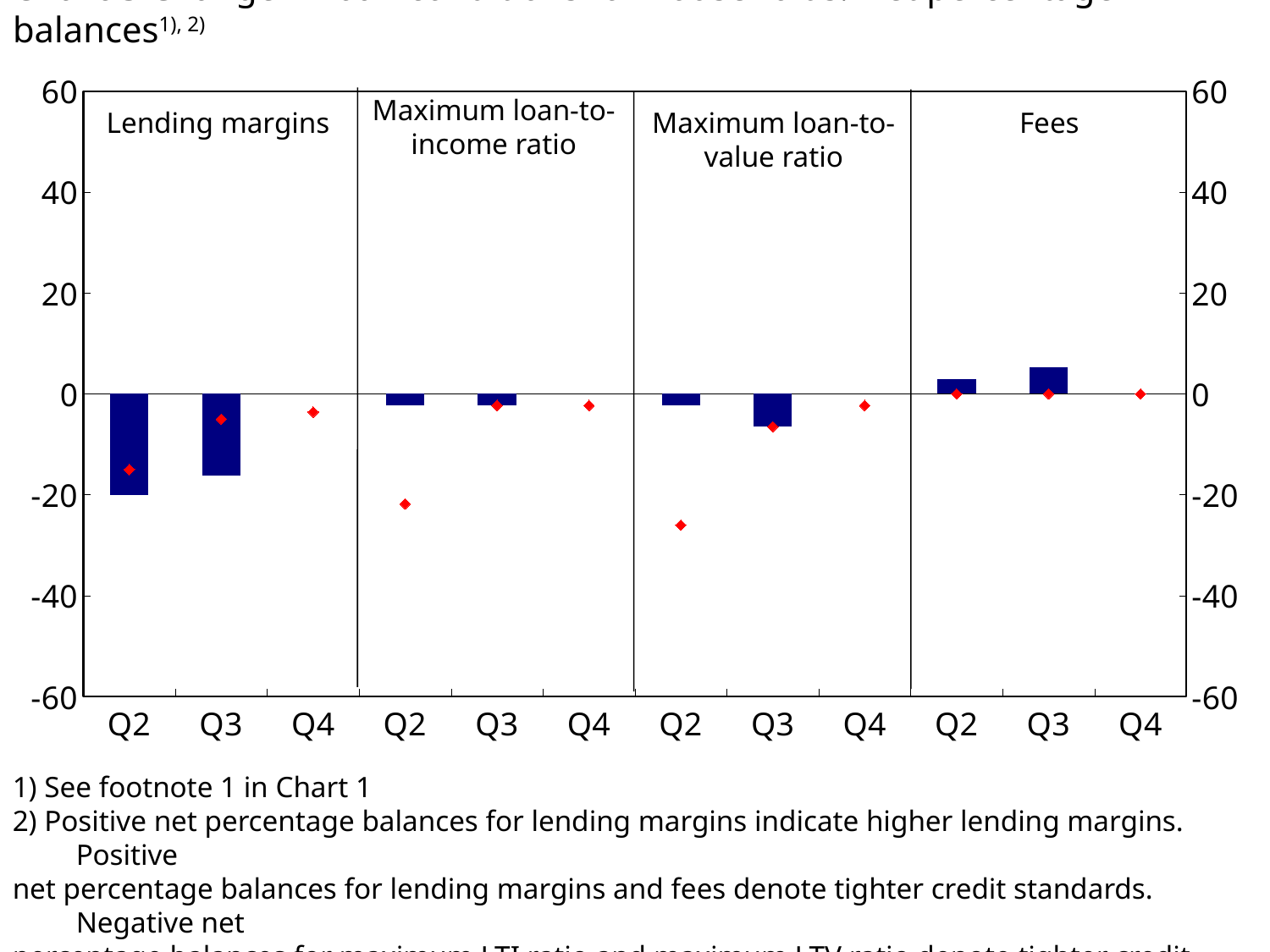
Is the Q2 bar in the Lending margins panel greater or less than -10? less In the Maximum loan-to-value ratio panel, which bar is lower, Q2 or Q3? Q3 What kind of chart is shown on the slide? bar chart Is the red diamond marker for Q2 in the Maximum loan-to-value ratio panel greater or less than -20? less Is the Q3 bar in the Lending margins panel greater or less than -10? less Which panel is the only one with bars above zero? Fees What is the highest value shown on the vertical axis? 60 How many quarters are shown on the x axis of each panel? 3 Which bar is the lowest in the whole chart? Lending margins Q2 How many panels (categories) does the chart have? 4 In the Fees panel, which bar is higher, Q2 or Q3? Q3